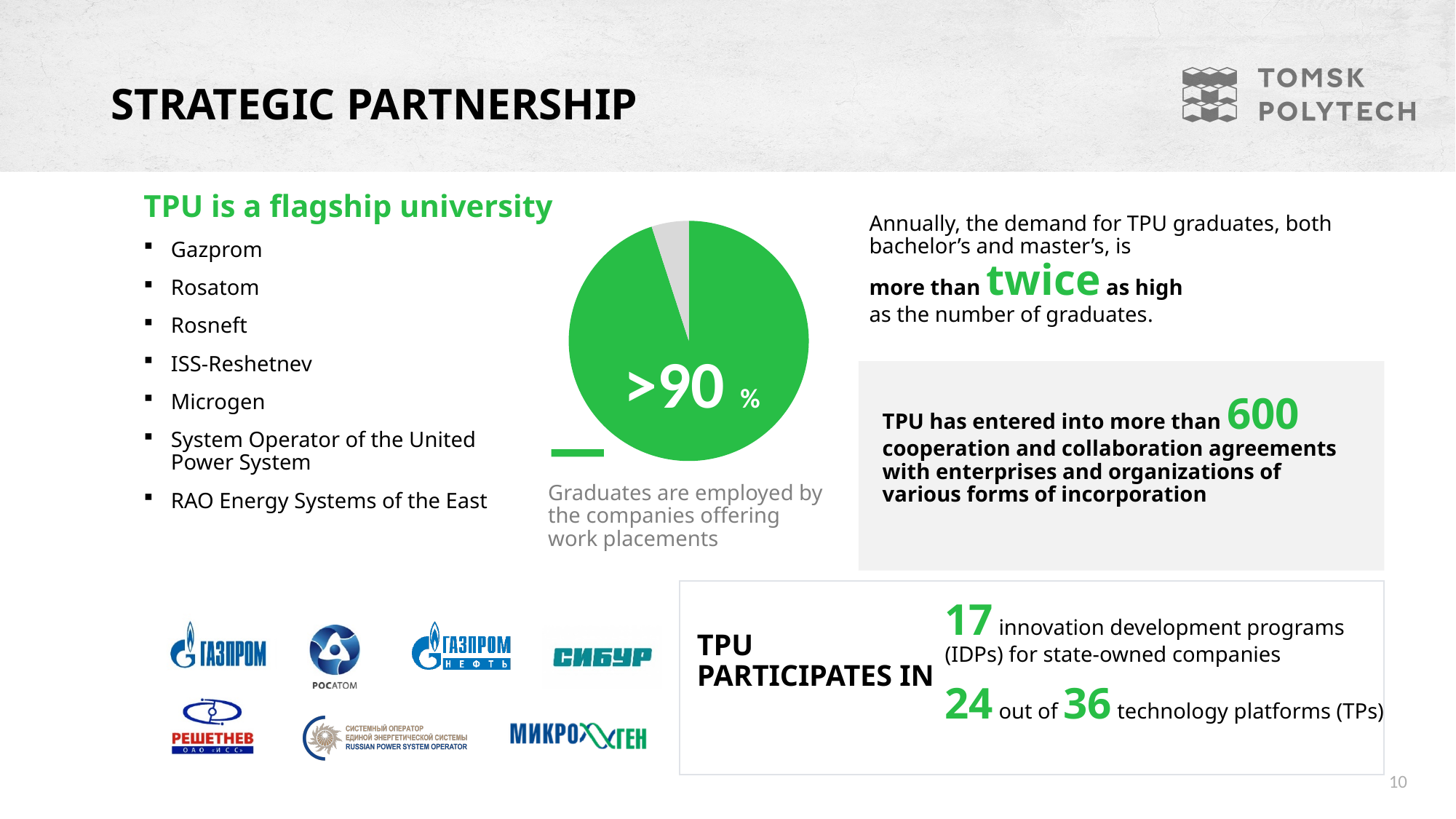
Is the share of the green slice in the pie chart greater or less than 50%? greater What value is printed on the pie chart? >90% What colour is the largest slice of the pie chart? green How many slices does the pie chart have? 2 Which slice of the pie chart is the smallest? the grey slice What share of the pie does the green slice represent? >90% Is the share of the grey slice in the pie chart greater or less than 50%? less Which slice of the pie chart is larger, the green one or the grey one? green What kind of chart is shown on the slide? pie chart What does the pie chart represent, according to its caption? Graduates are employed by the companies offering work placements